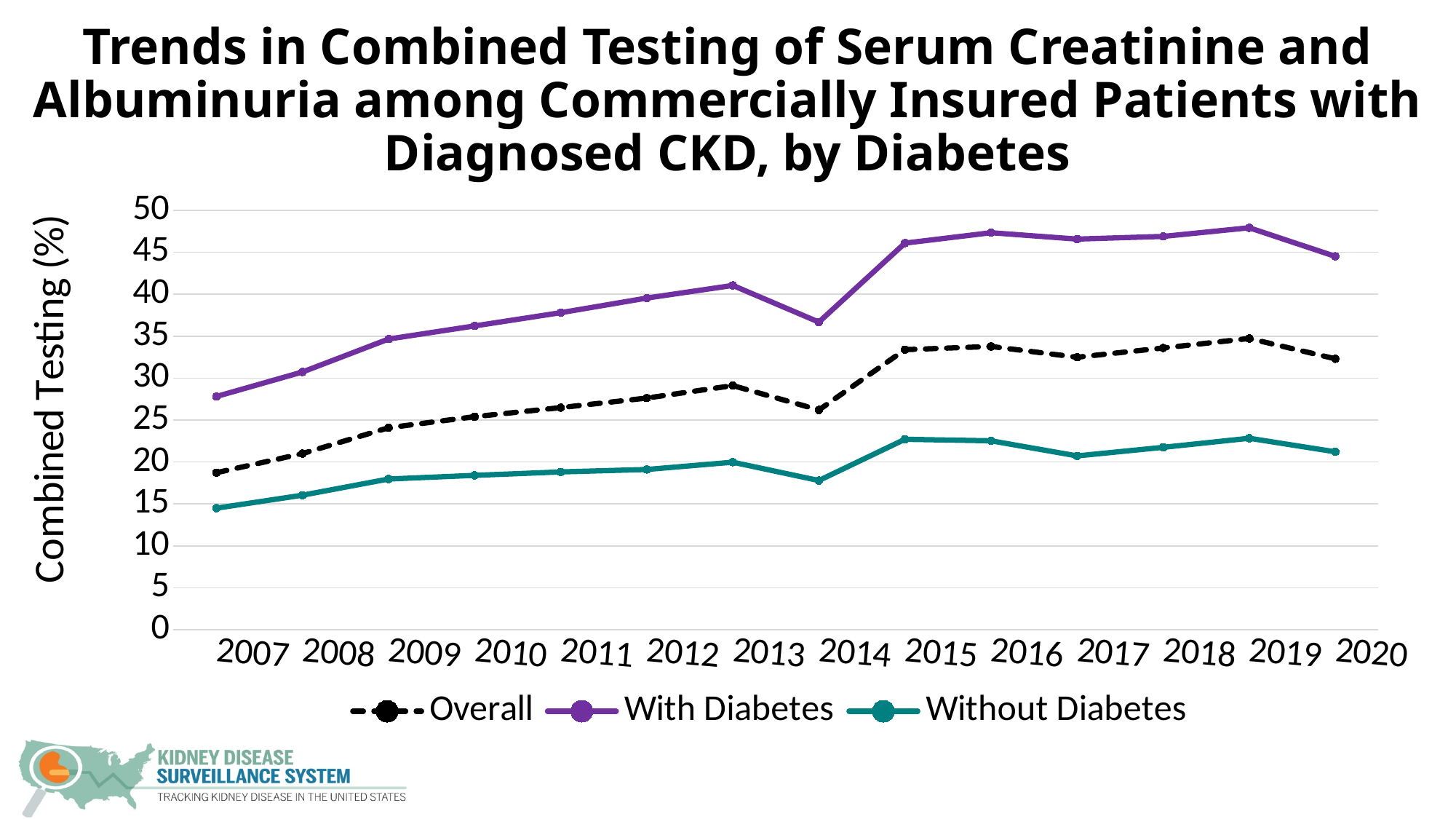
Is the value for With Diabetes in 2007 greater or less than 30? less Is the value for Overall in 2019 greater or less than 30? greater How many years are plotted along the x axis? 14 How many series does the legend list? 3 Does the Overall series rise or fall from 2007 to 2013? rise Which series is higher in 2015, With Diabetes or Without Diabetes? With Diabetes In which year is the Without Diabetes series at its lowest? 2007 What is the label of the y axis? Combined Testing (%) Is the value for With Diabetes in 2014 greater or less than 40? less What kind of chart is shown on the slide? line chart